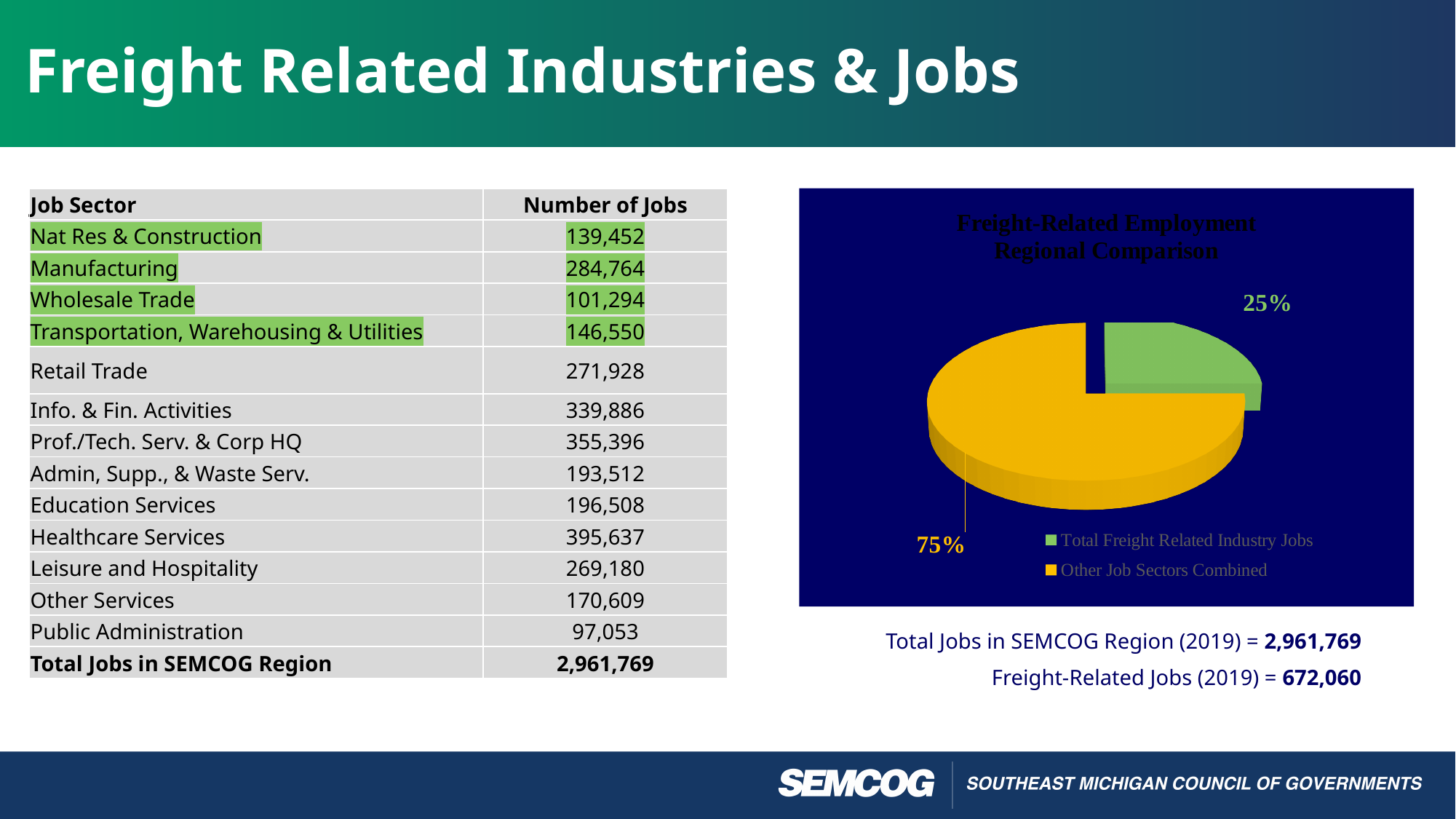
What colour is the Total Freight Related Industry Jobs slice in the pie chart? green What is the title of the pie chart? Freight-Related Employment Regional Comparison How many slices does the pie chart have? 2 Which is larger in the pie chart: Total Freight Related Industry Jobs or Other Job Sectors Combined? Other Job Sectors Combined What is the difference in percentage points between the Other Job Sectors Combined slice and the Total Freight Related Industry Jobs slice? 50 percentage points What share of the pie does Total Freight Related Industry Jobs represent? 25% What share of the pie does Other Job Sectors Combined represent? 75% How many entries does the pie chart's legend list? 2 Which slice of the pie chart is the largest? Other Job Sectors Combined What kind of chart is shown on the slide? pie chart Which slice of the pie chart is the smallest? Total Freight Related Industry Jobs